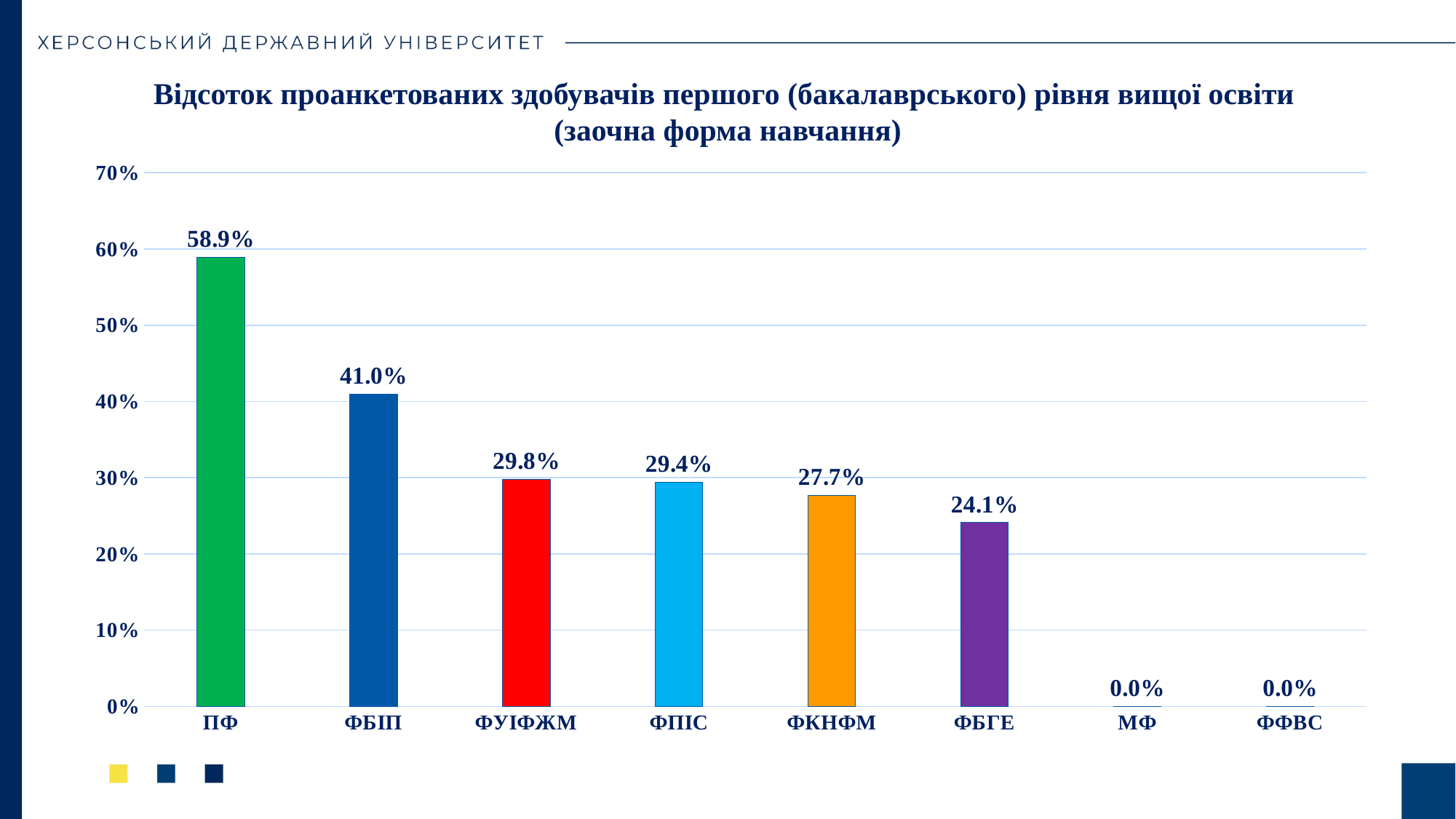
Which category has the highest value? ПФ Is the value for ФУІФЖМ greater or less than 20%? greater What is the value for МФ? 0.0% What is the difference between the values for ФКНФМ and ФБГЕ? 3.6% What is the value for ПФ? 58.9% Which is larger, the value for ФБІП or the value for ФПІС? ФБІП What is the value for ФБГЕ? 24.1% What is the value for ФКНФМ? 27.7% What is the value for ФБІП? 41.0% How many categories are shown on the x axis? 8 What kind of chart is shown on the slide? bar chart What is the difference between the values for ПФ and ФБІП? 17.9%